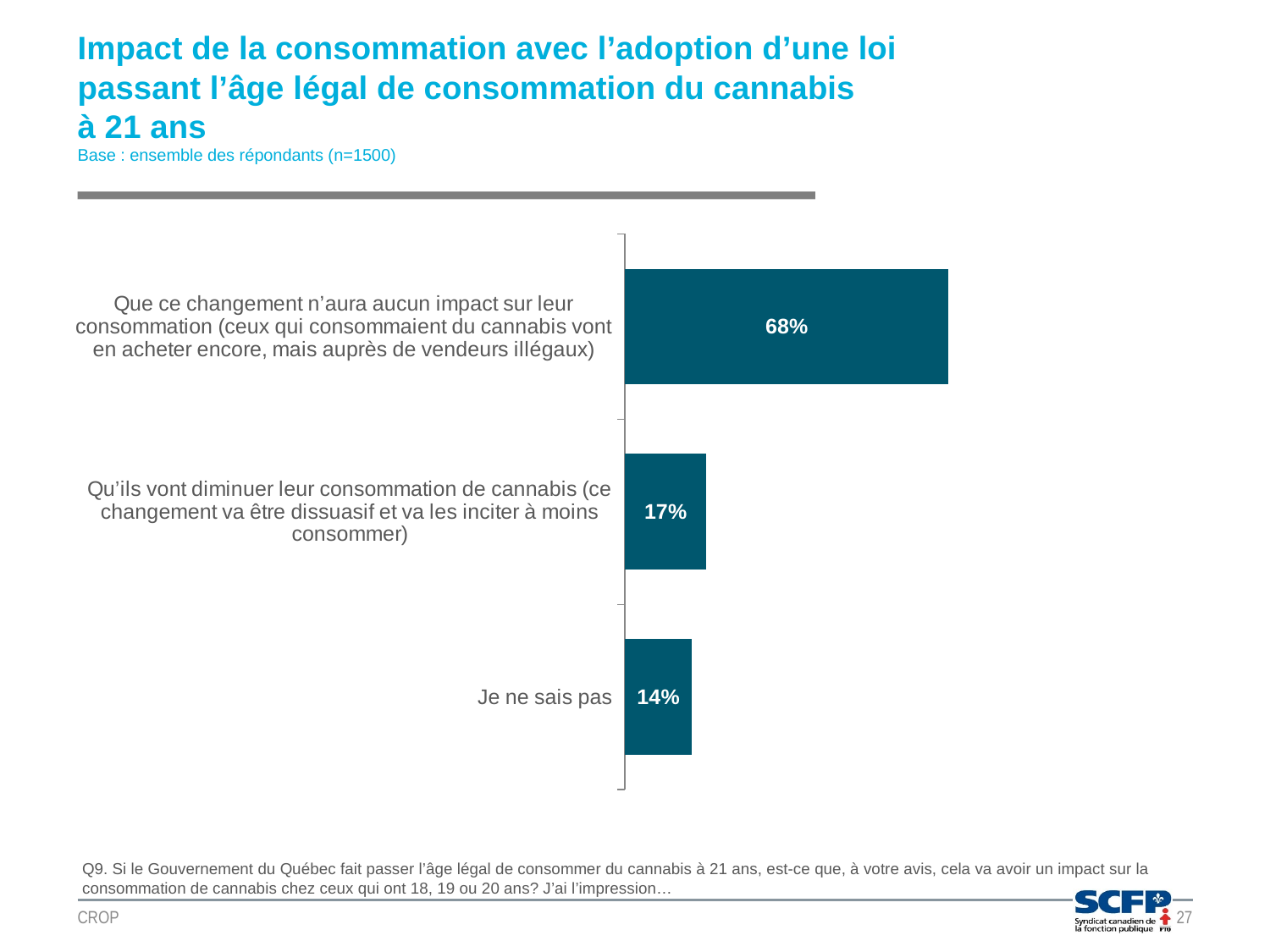
What percentage of respondents said the change will have no impact on consumption ("Que ce changement n'aura aucun impact sur leur consommation")? 68% Which response category has the lowest percentage? Je ne sais pas What type of chart is shown on the slide? Bar chart What is the sample size (n) stated in the base line under the title? 1500 What is the difference in percentage points between the "aucun impact" response and the "diminuer leur consommation" response? 51 How many response categories are shown in the chart? 3 What percentage of respondents answered "Je ne sais pas"? 14% What is the total of the three percentages shown in the chart? 99% What percentage of respondents said that they will reduce their cannabis consumption ("Qu'ils vont diminuer leur consommation de cannabis")? 17% What is the difference in percentage points between "Qu'ils vont diminuer leur consommation" and "Je ne sais pas"? 3 Which response category has the highest percentage? Que ce changement n'aura aucun impact sur leur consommation Which is larger: the percentage for "Qu'ils vont diminuer leur consommation de cannabis" or for "Je ne sais pas"? Qu'ils vont diminuer leur consommation de cannabis